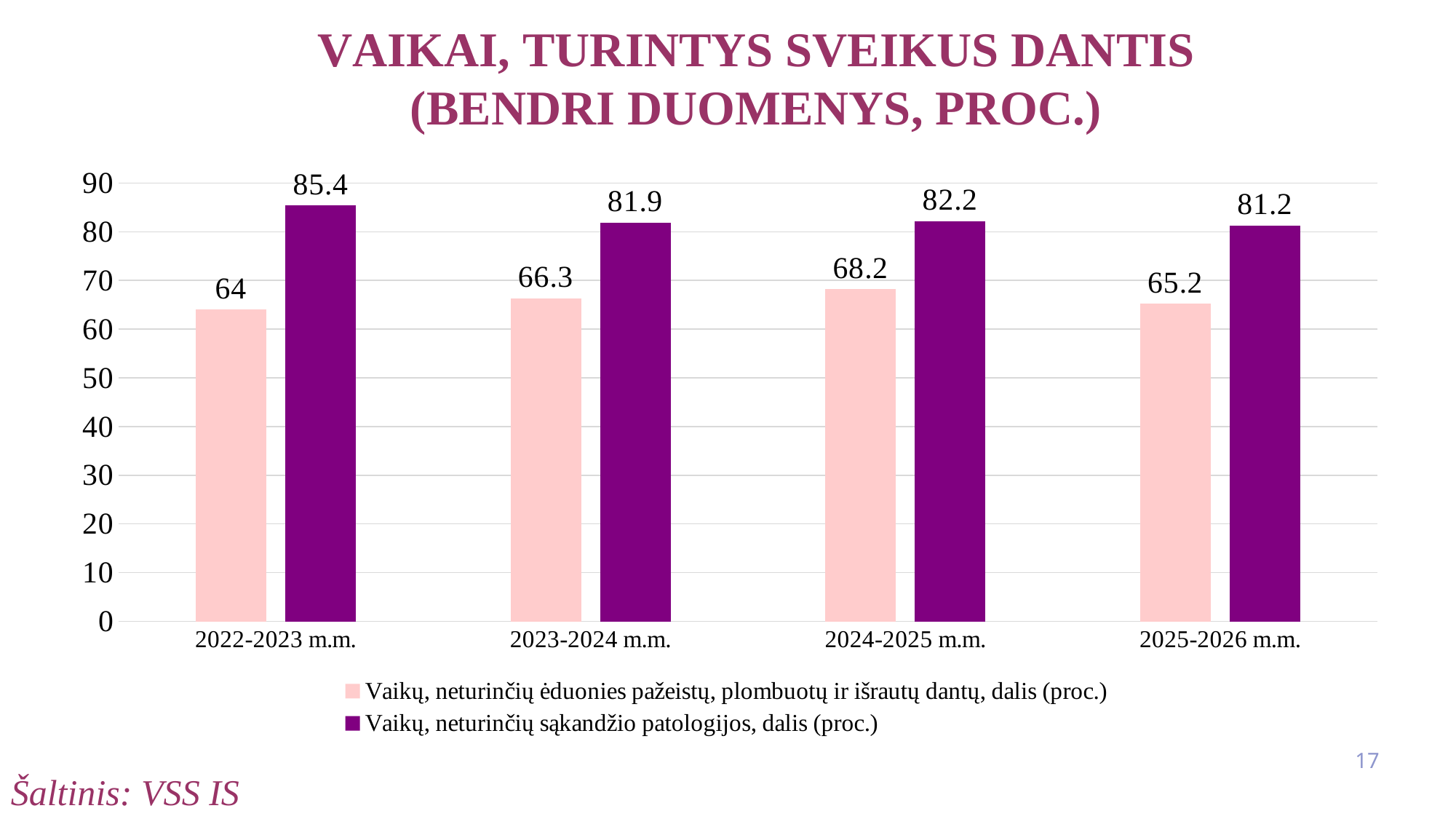
What is the value for 'Vaikų, neturinčių ėduonies pažeistų, plombuotų ir išrautų dantų, dalis (proc.)' in 2022-2023 m.m.? 64 How many series does the legend list? 2 Is the value for 'Vaikų, neturinčių sąkandžio patologijos, dalis (proc.)' in 2022-2023 m.m. greater or less than 80? greater In which school year is the value for 'Vaikų, neturinčių ėduonies pažeistų, plombuotų ir išrautų dantų, dalis (proc.)' lowest? 2022-2023 m.m. What is the value for 'Vaikų, neturinčių sąkandžio patologijos, dalis (proc.)' in 2025-2026 m.m.? 81.2 Which is larger: the value for 'Vaikų, neturinčių sąkandžio patologijos, dalis (proc.)' in 2024-2025 m.m. or in 2025-2026 m.m.? 2024-2025 m.m. What is the value for 'Vaikų, neturinčių ėduonies pažeistų, plombuotų ir išrautų dantų, dalis (proc.)' in 2024-2025 m.m.? 68.2 What is the difference between the two series' values in 2023-2024 m.m.? 15.6 What kind of chart is shown on the slide? bar chart In which school year is the value for 'Vaikų, neturinčių sąkandžio patologijos, dalis (proc.)' highest? 2022-2023 m.m. What colour are the bars for 'Vaikų, neturinčių sąkandžio patologijos, dalis (proc.)'? purple How many school years are shown on the x axis? 4